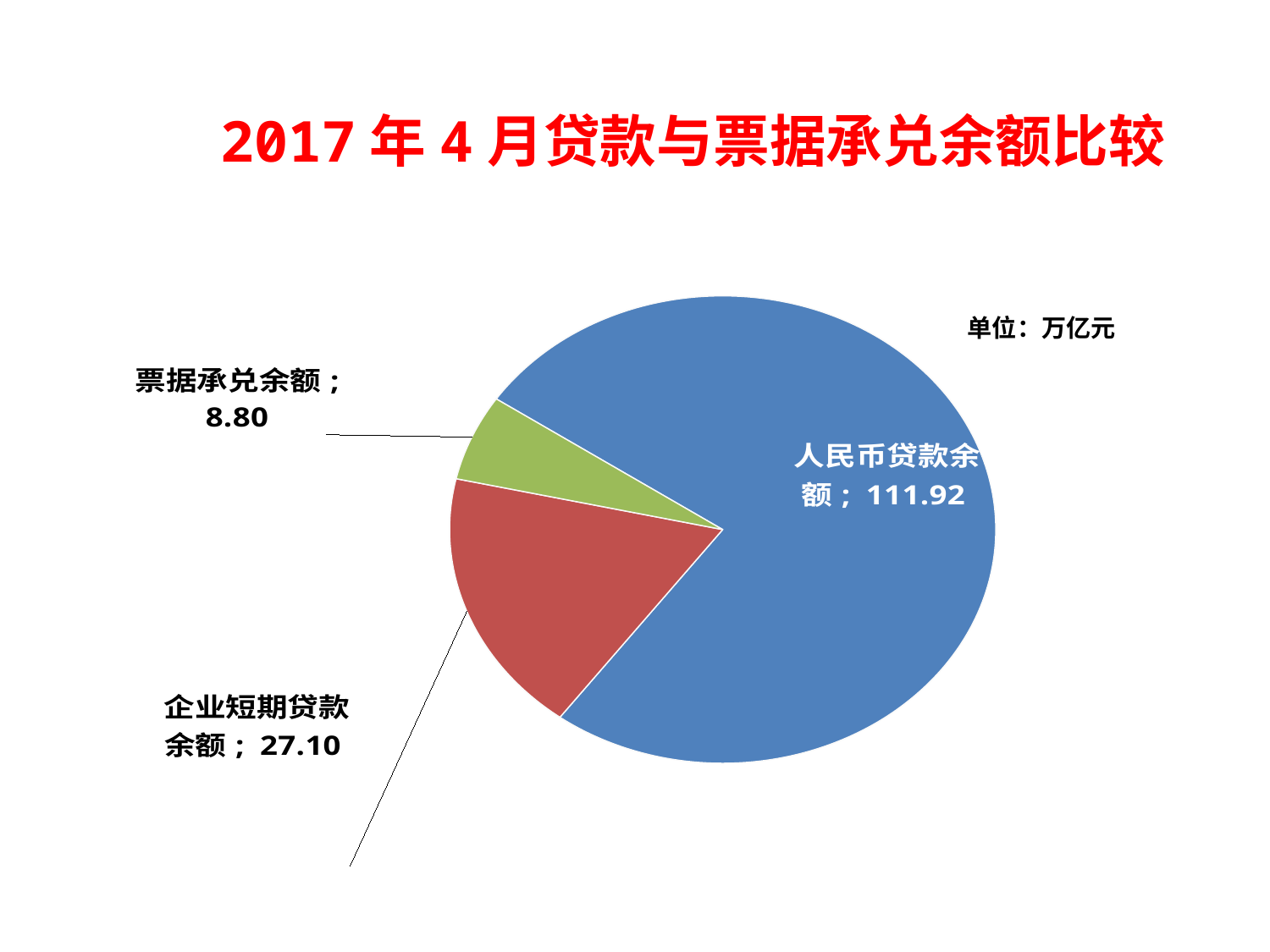
Which category has the smallest slice of the pie? 票据承兑余额 What is the value for 票据承兑余额? 8.80 What is the difference between 企业短期贷款余额 and 票据承兑余额? 18.30 What is the value for 人民币贷款余额? 111.92 How many slices does the pie chart have? 3 What is the value for 企业短期贷款余额? 27.10 What kind of chart is shown on the slide? pie chart What unit is stated for the values in the chart? 万亿元 Which category has the largest slice of the pie? 人民币贷款余额 Which is larger, 企业短期贷款余额 or 票据承兑余额? 企业短期贷款余额 What is the title of the slide? 2017年4月贷款与票据承兑余额比较 What is the difference between 人民币贷款余额 and 企业短期贷款余额? 84.82